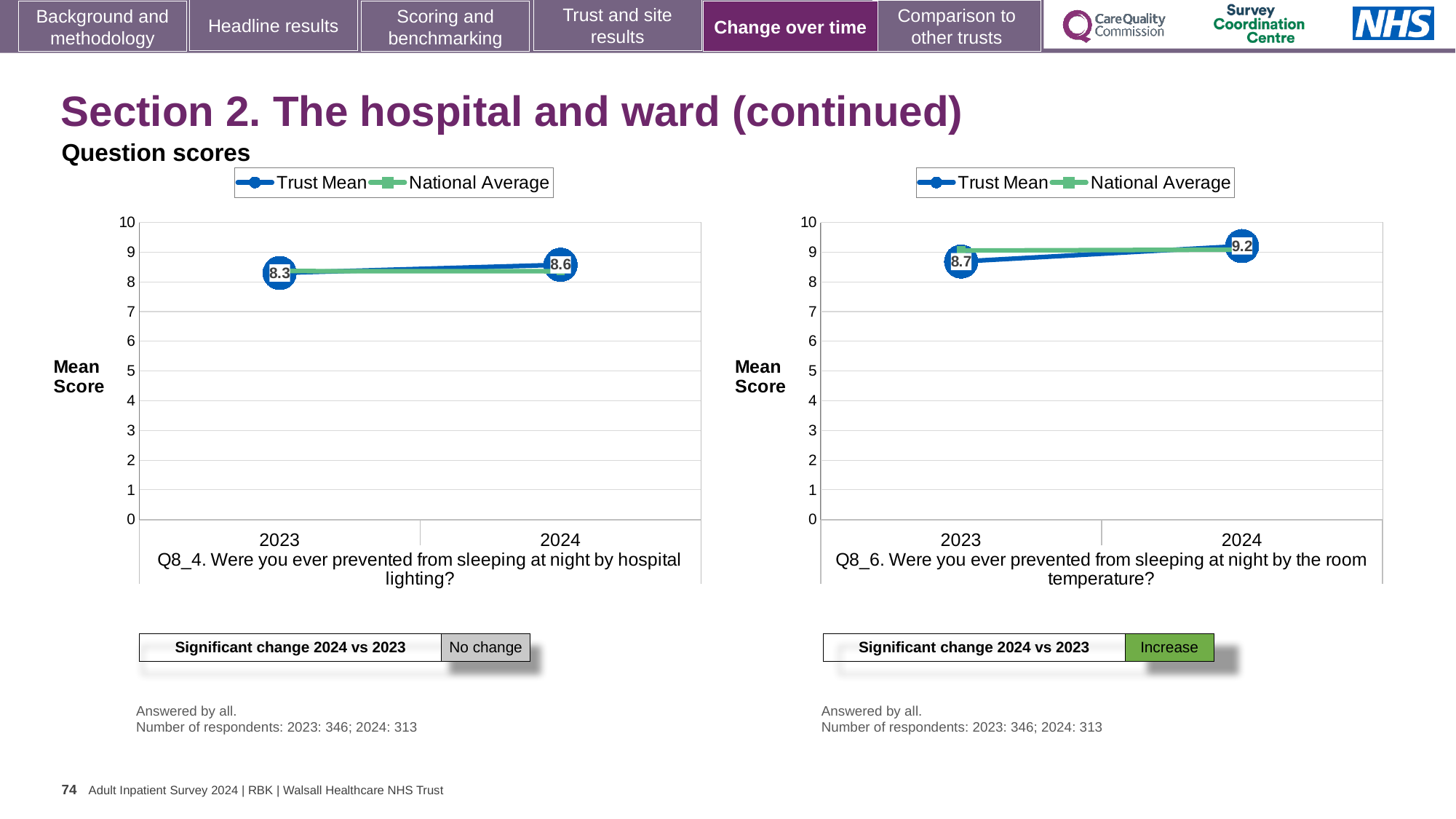
In the Q8_4 chart (left), what is the Trust Mean score for 2024? 8.6 What kind of chart is the Q8_6 chart (right)? line chart In the Q8_6 chart (right), is the Trust Mean for 2024 greater or less than 9? greater What does the significant change box below the Q8_6 chart (right) say? Increase In the Q8_6 chart (right), what is the Trust Mean score for 2024? 9.2 In the Q8_6 chart (right), what is the Trust Mean score for 2023? 8.7 How many years are shown on the x axis of the Q8_6 chart (right)? 2 In the Q8_4 chart (left), what is the Trust Mean score for 2023? 8.3 In the Q8_6 chart (right), by how much did the Trust Mean change from 2023 to 2024? 0.5 How many series does the legend of the Q8_4 chart (left) list? 2 In the Q8_4 chart (left), by how much did the Trust Mean change from 2023 to 2024? 0.3 In the Q8_4 chart (left), does the Trust Mean rise or fall from 2023 to 2024? rise